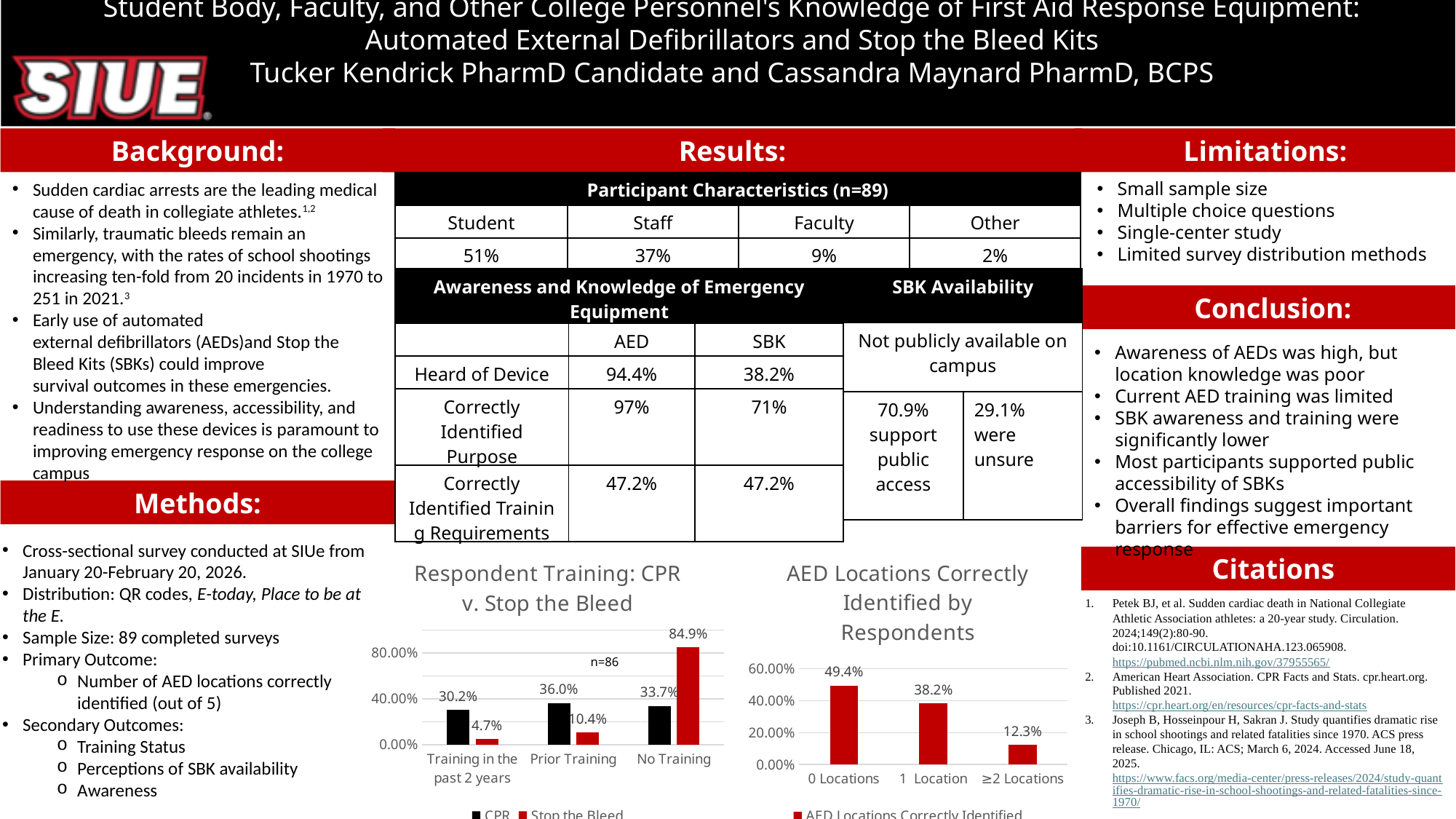
In the 'Respondent Training: CPR v. Stop the Bleed' chart, what is the Stop the Bleed value for Training in the past 2 years? 4.7% In the 'Respondent Training: CPR v. Stop the Bleed' chart, what is the Stop the Bleed value for No Training? 84.9% In the 'Respondent Training: CPR v. Stop the Bleed' chart, how many series does the legend list? 2 In the 'Respondent Training: CPR v. Stop the Bleed' chart, what is the CPR value for Prior Training? 36.0% In the 'Respondent Training: CPR v. Stop the Bleed' chart, which category has the highest Stop the Bleed value? No Training In the 'AED Locations Correctly Identified by Respondents' chart, what is the value for 1 Location? 38.2% In the 'Respondent Training: CPR v. Stop the Bleed' chart, which category has the lowest CPR value? Training in the past 2 years In the 'Respondent Training: CPR v. Stop the Bleed' chart, what sample size is noted on the chart? n=86 In the 'Respondent Training: CPR v. Stop the Bleed' chart, what is the difference between the Stop the Bleed and CPR values for No Training? 51.2% In the 'AED Locations Correctly Identified by Respondents' chart, which category has the lowest value? ≥2 Locations What kind of chart is the 'AED Locations Correctly Identified by Respondents' chart? bar chart In the 'AED Locations Correctly Identified by Respondents' chart, do the values rise or fall from 0 Locations to ≥2 Locations? fall